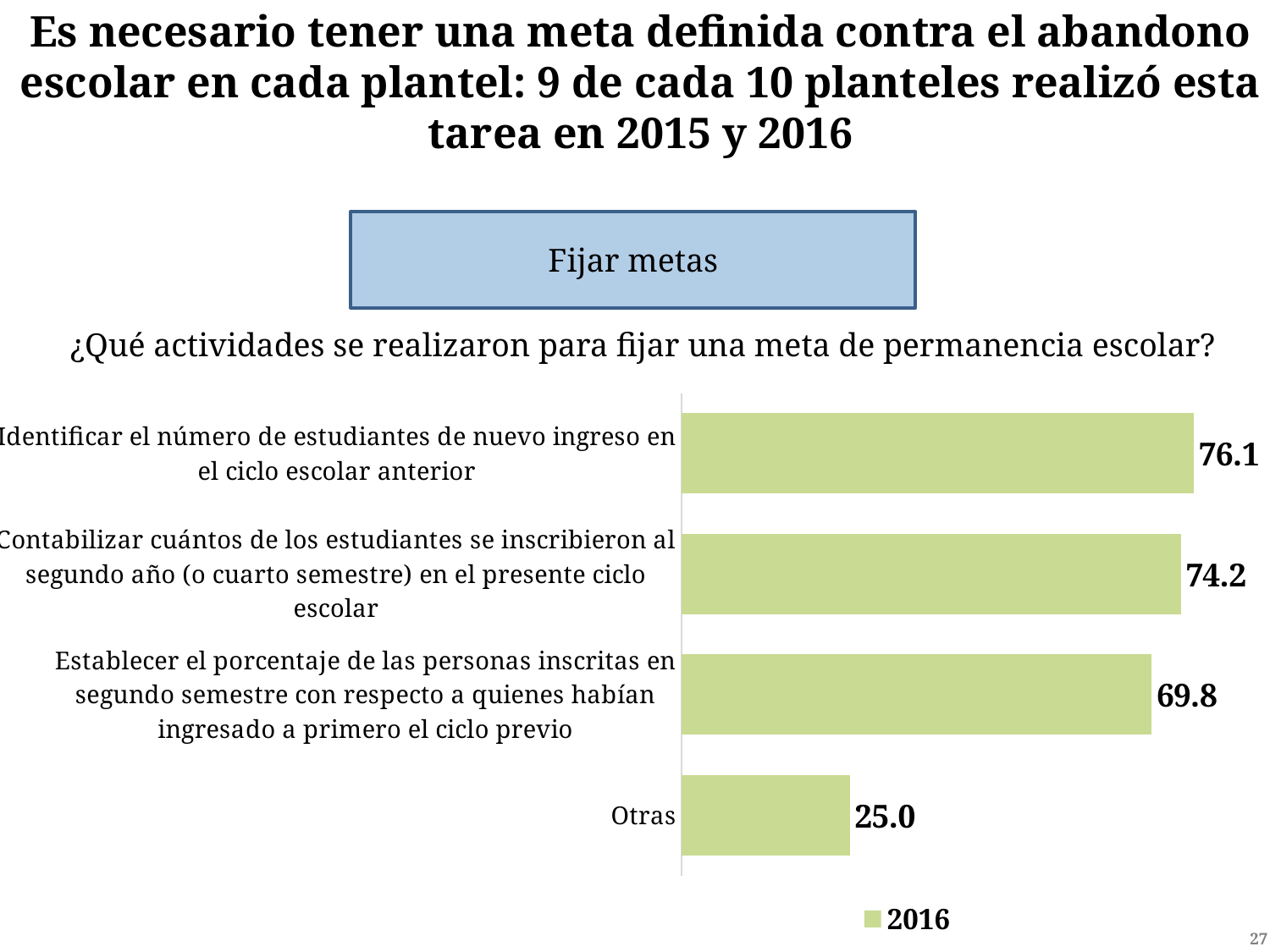
What kind of chart is shown on the slide? Bar chart What series name does the legend show? 2016 How many series does the legend list? 1 What is the difference between the values for "Identificar el número de estudiantes de nuevo ingreso en el ciclo escolar anterior" and "Otras"? 51.1 What is the value for "Identificar el número de estudiantes de nuevo ingreso en el ciclo escolar anterior"? 76.1 Which category has the highest value? Identificar el número de estudiantes de nuevo ingreso en el ciclo escolar anterior How many categories does the chart show? 4 What is the value for "Establecer el porcentaje de las personas inscritas en segundo semestre con respecto a quienes habían ingresado a primero el ciclo previo"? 69.8 Which category has the lowest value? Otras What is the value for "Otras"? 25.0 What is the difference between the values for "Contabilizar cuántos de los estudiantes se inscribieron al segundo año (o cuarto semestre) en el presente ciclo escolar" and "Establecer el porcentaje de las personas inscritas en segundo semestre con respecto a quienes habían ingresado a primero el ciclo previo"? 4.4 Which is larger: the value for "Contabilizar cuántos de los estudiantes se inscribieron al segundo año (o cuarto semestre) en el presente ciclo escolar" or the value for "Otras"? Contabilizar cuántos de los estudiantes se inscribieron al segundo año (o cuarto semestre) en el presente ciclo escolar